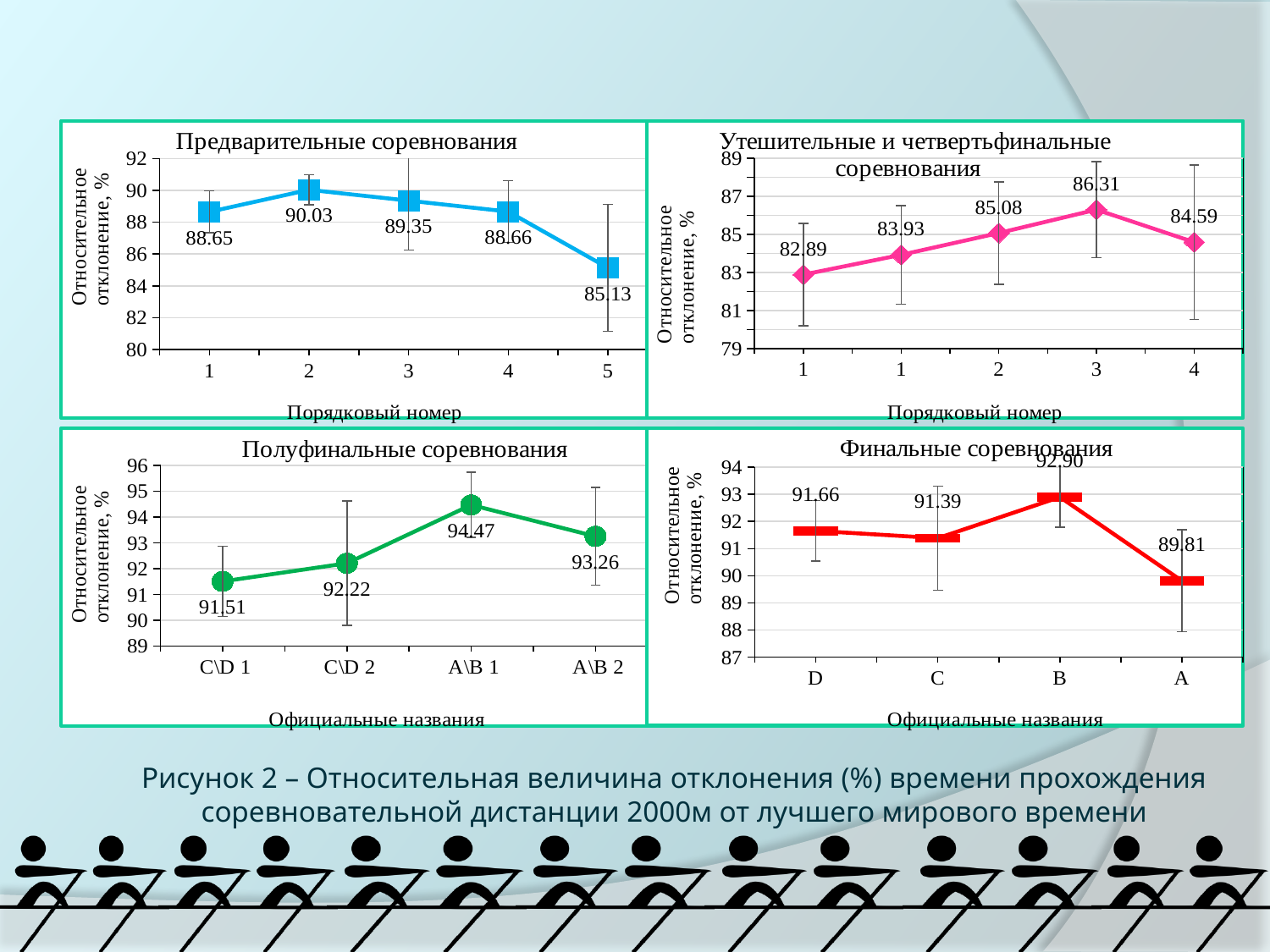
In the chart titled "Полуфинальные соревнования", do the values rise or fall from C\D 1 to A\B 1? rise In the chart titled "Предварительные соревнования", how many data points are plotted? 5 In the chart titled "Полуфинальные соревнования", what is the value for A\B 1? 94.47 In the chart titled "Предварительные соревнования", which ordinal number has the lowest value? 5 In the chart titled "Предварительные соревнования", what is the value at ordinal number 2? 90.03 In the chart titled "Предварительные соревнования", what is the difference between the values at ordinal numbers 2 and 5? 4.90 In the chart titled "Полуфинальные соревнования", which category has the lowest value? C\D 1 In the chart titled "Утешительные и четвертьфинальные соревнования", what is the value at ordinal number 4? 84.59 In the chart titled "Утешительные и четвертьфинальные соревнования", what is the highest value shown? 86.31 In the chart titled "Финальные соревнования", what is the value for A? 89.81 In the chart titled "Финальные соревнования", which is larger, the value for B or the value for A? B What kind of chart is the chart titled "Финальные соревнования"? line chart